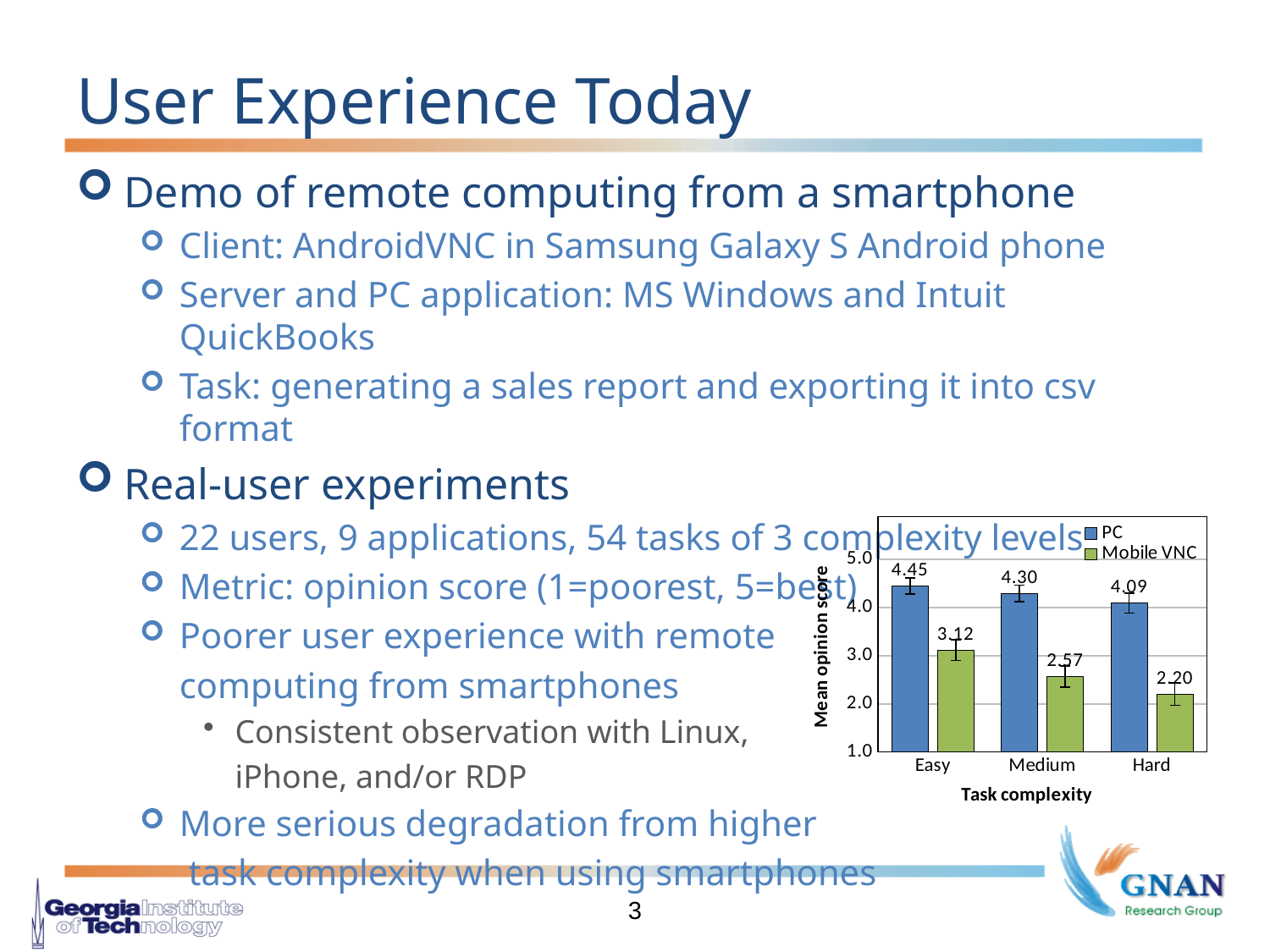
What is the mean opinion score for Mobile VNC on the Medium task? 2.57 Which is larger on the Medium task, the PC score or the Mobile VNC score? PC What is the mean opinion score for PC on the Easy task? 4.45 Which task complexity has the lowest Mobile VNC mean opinion score? Hard What kind of chart is shown on the slide? Bar chart How many series does the legend list? 2 Do the Mobile VNC scores rise or fall as task complexity goes from Easy to Hard? Fall How many task complexity categories are shown on the x axis? 3 What is the mean opinion score for Mobile VNC on the Hard task? 2.20 Which task complexity has the highest PC mean opinion score? Easy What is the difference between the PC and Mobile VNC mean opinion scores on the Hard task? 1.89 Is the Mobile VNC value for Easy greater or less than 3.0? greater